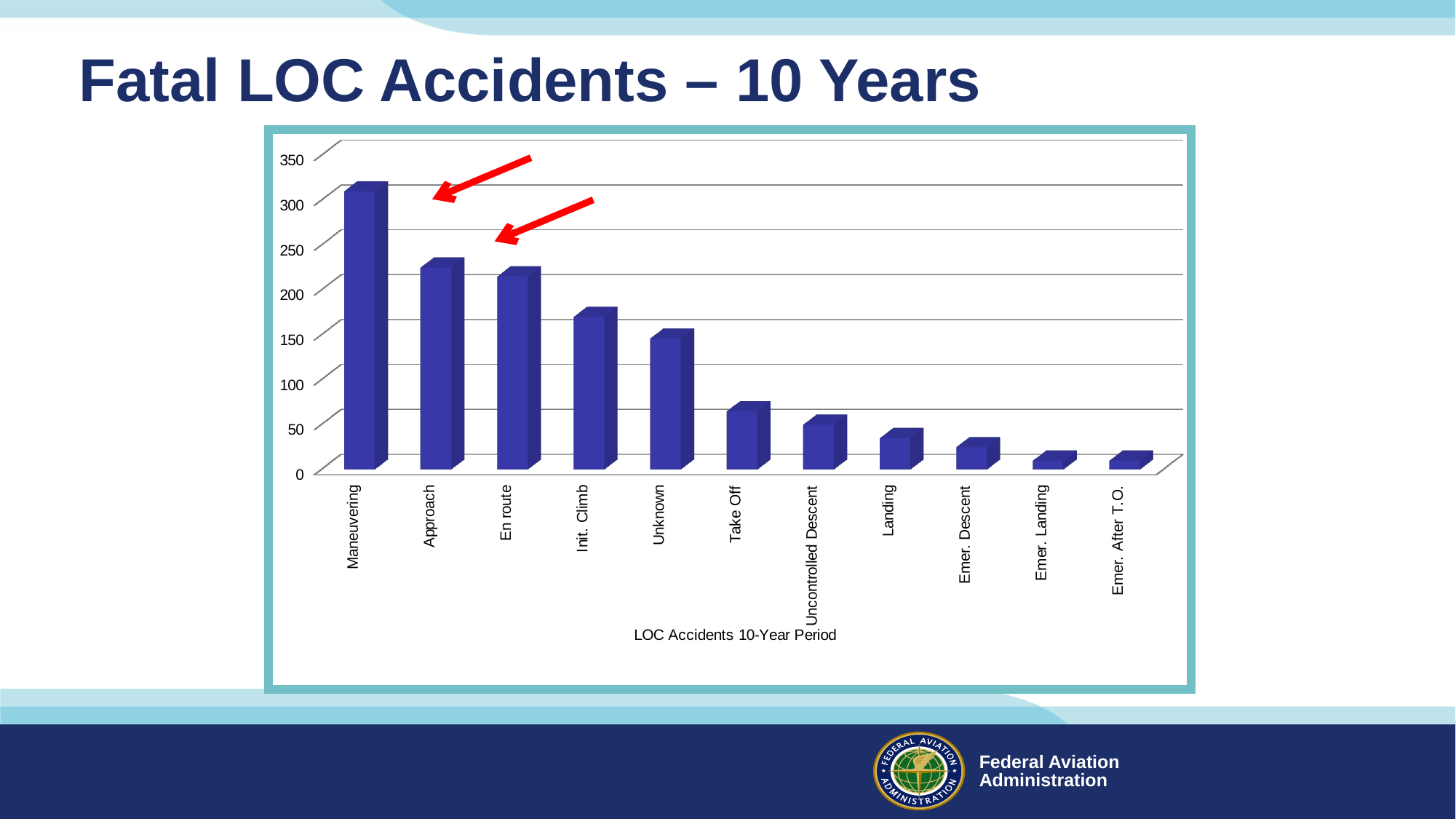
Is the value for Landing greater or less than 50? less Do the values rise or fall moving from left to right along the x axis? fall Is the value for Approach greater or less than 200? greater Which is larger, the value for Take Off or the value for Landing? Take Off What is the title printed below the x axis of the chart? LOC Accidents 10-Year Period Is the value for Maneuvering greater or less than 250? greater What kind of chart is shown on the slide? bar chart How many categories are plotted on the x axis? 11 Which category has the highest number of fatal LOC accidents? Maneuvering Which is larger, the value for Init. Climb or the value for Unknown? Init. Climb